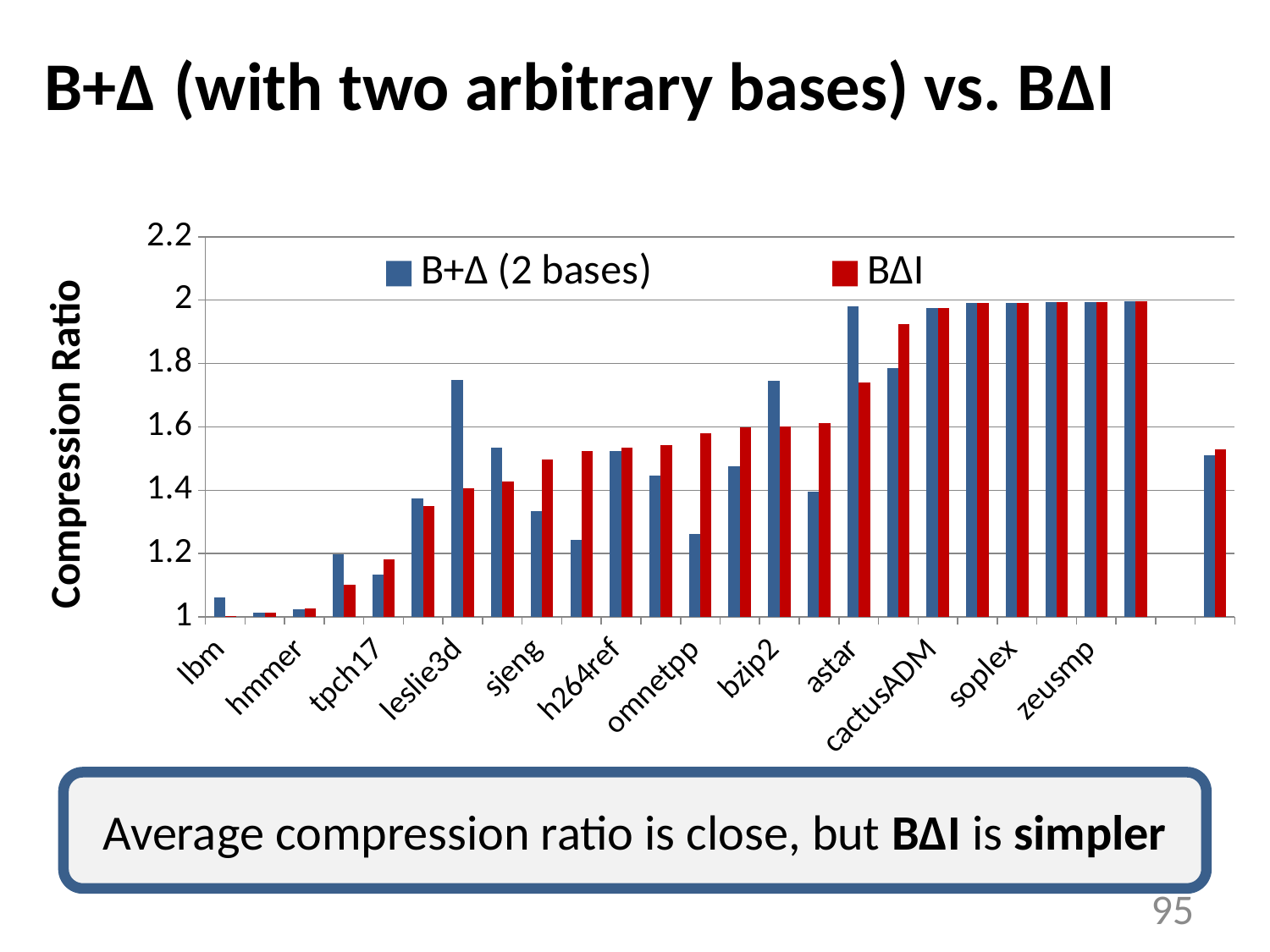
For lbm, which series has the larger compression ratio, B+Δ (2 bases) or BΔI? B+Δ (2 bases) Is the B+Δ (2 bases) value for astar greater or less than 1.6? greater What are the two series named in the chart's legend? B+Δ (2 bases) and BΔI Is the B+Δ (2 bases) value for hmmer greater or less than 1.4? less Is the BΔI value for cactusADM greater or less than 1.8? greater Do the BΔI values generally rise or fall moving from lbm on the left to zeusmp on the right? rise What is the label of the vertical axis of the chart? Compression Ratio What kind of chart is shown on the slide? bar chart How many series does the chart's legend list? 2